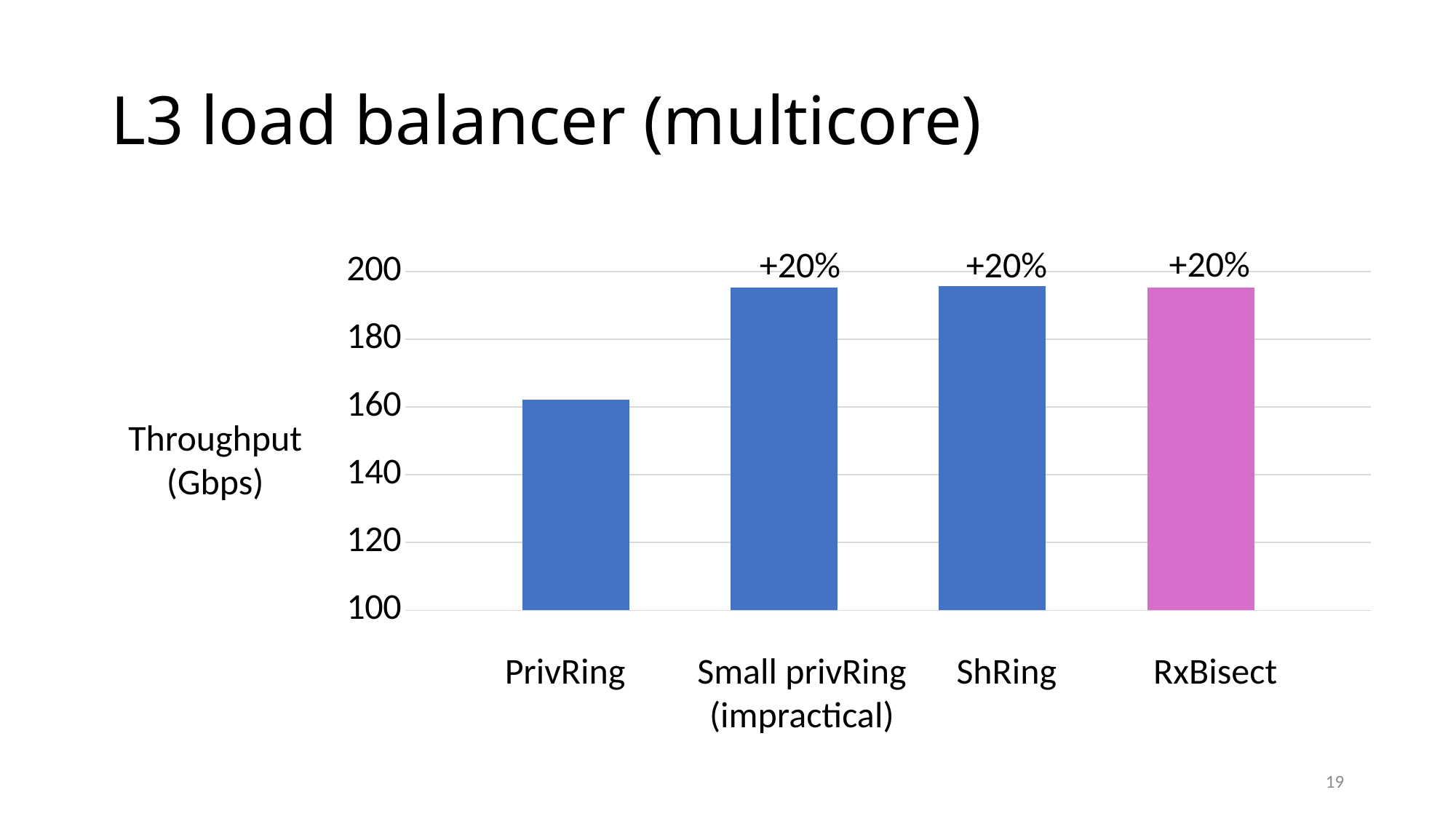
What annotation is printed above the ShRing bar? +20% Which category has the lowest throughput? PrivRing Is the value for PrivRing greater or less than 180? less Is the value for Small privRing (impractical) greater or less than 180? greater What is the label of the y axis? Throughput (Gbps) Is the value for RxBisect greater or less than 200? less Which bar is coloured differently (pink) from the others? RxBisect Which is larger, the value for PrivRing or the value for RxBisect? RxBisect How many categories are plotted on the x axis? 4 What kind of chart is shown on the slide? bar chart